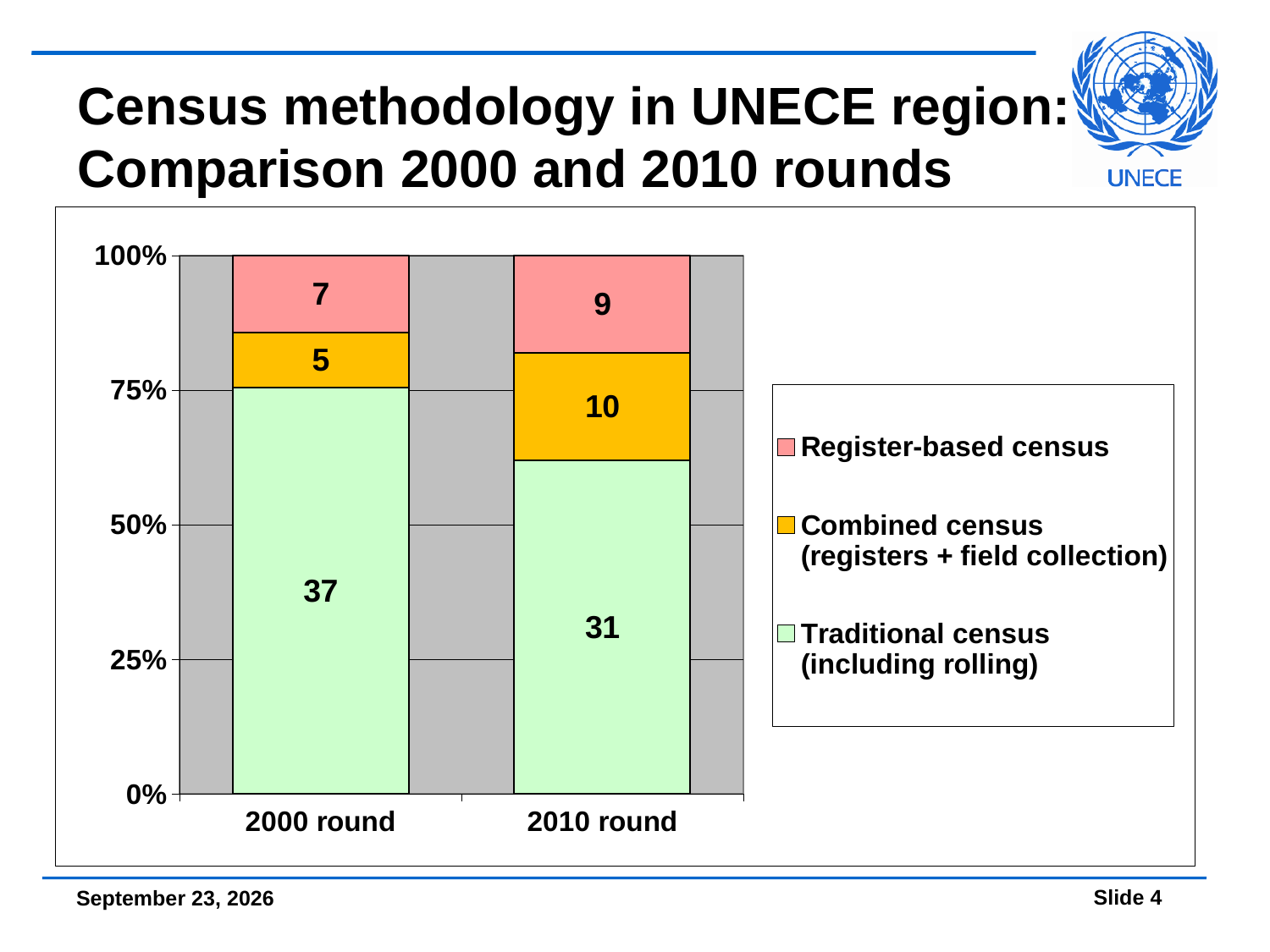
What is the value for Register-based census in the 2010 round? 9 Does the Traditional census share of the 2010 round bar reach above or below 50% on the axis? above What kind of chart is shown on the slide? Stacked bar chart How many series does the legend list? 3 How many categories are shown on the x axis? 2 Which is larger: the Combined census value in the 2000 round or in the 2010 round? 2010 round What is the value for Traditional census (including rolling) in the 2000 round? 37 What is the value for Register-based census in the 2000 round? 7 What is the value for Combined census (registers + field collection) in the 2010 round? 10 Which series has the largest value in the 2000 round? Traditional census (including rolling) What is the total of the three values in the 2010 round bar? 50 What is the difference between the Traditional census values for the 2000 round and the 2010 round? 6